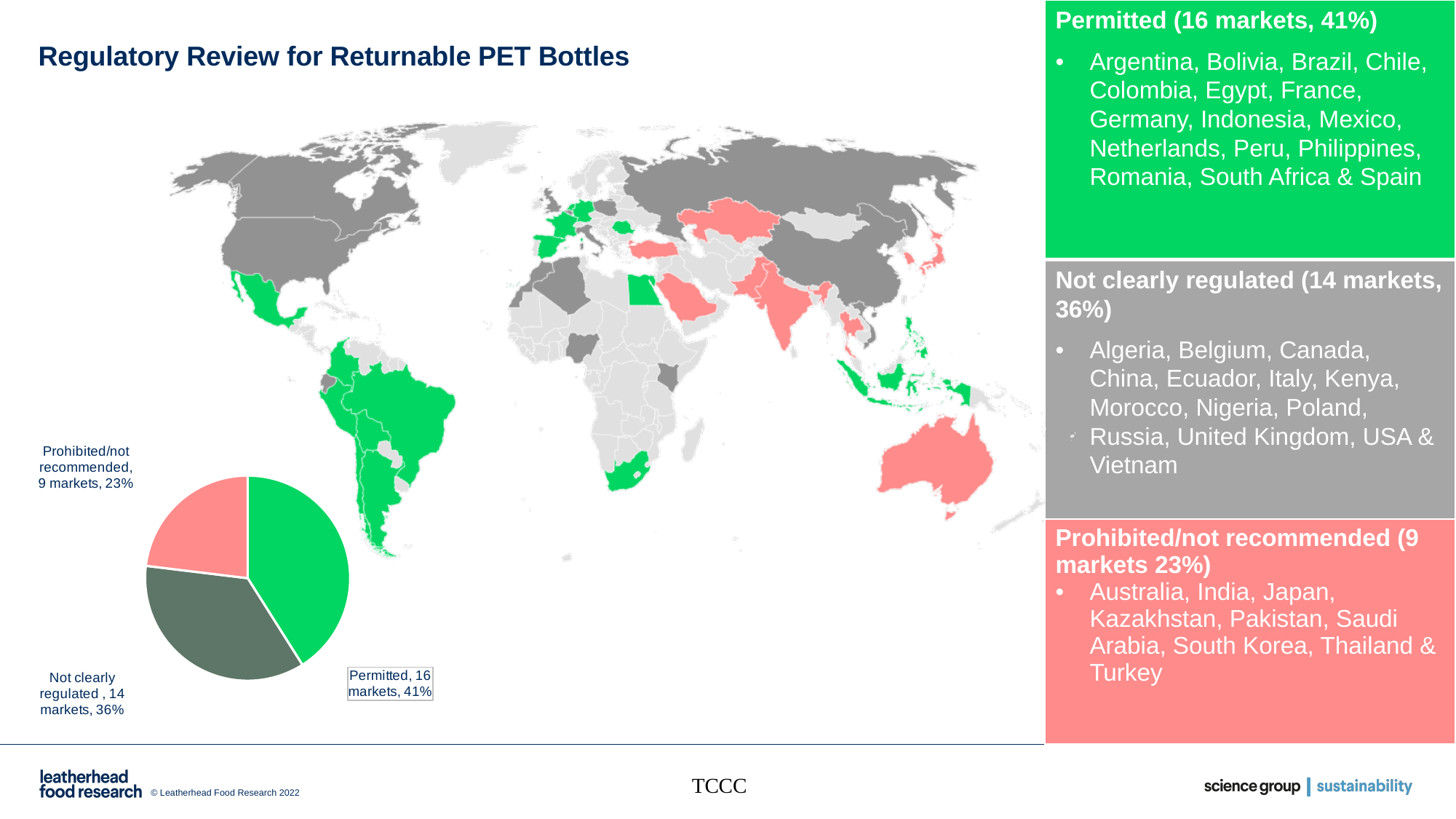
In the pie chart, what share of the pie is the Prohibited/not recommended slice? 23% How many slices does the pie chart have? 3 In the pie chart, how many markets are in the Permitted category? 16 In the pie chart, what share of the pie is the Permitted slice? 41% Which category in the pie chart has the fewest markets? Prohibited/not recommended In the pie chart, how many markets are in the Prohibited/not recommended category? 9 What kind of chart is shown at the bottom left of the slide? pie chart In the pie chart, how many markets are in the Not clearly regulated category? 14 Which category in the pie chart has the most markets? Permitted In the pie chart, how many more markets are Permitted than Prohibited/not recommended? 7 What colour is the Permitted slice in the pie chart? green In the pie chart, what share of the pie is the Not clearly regulated slice? 36%